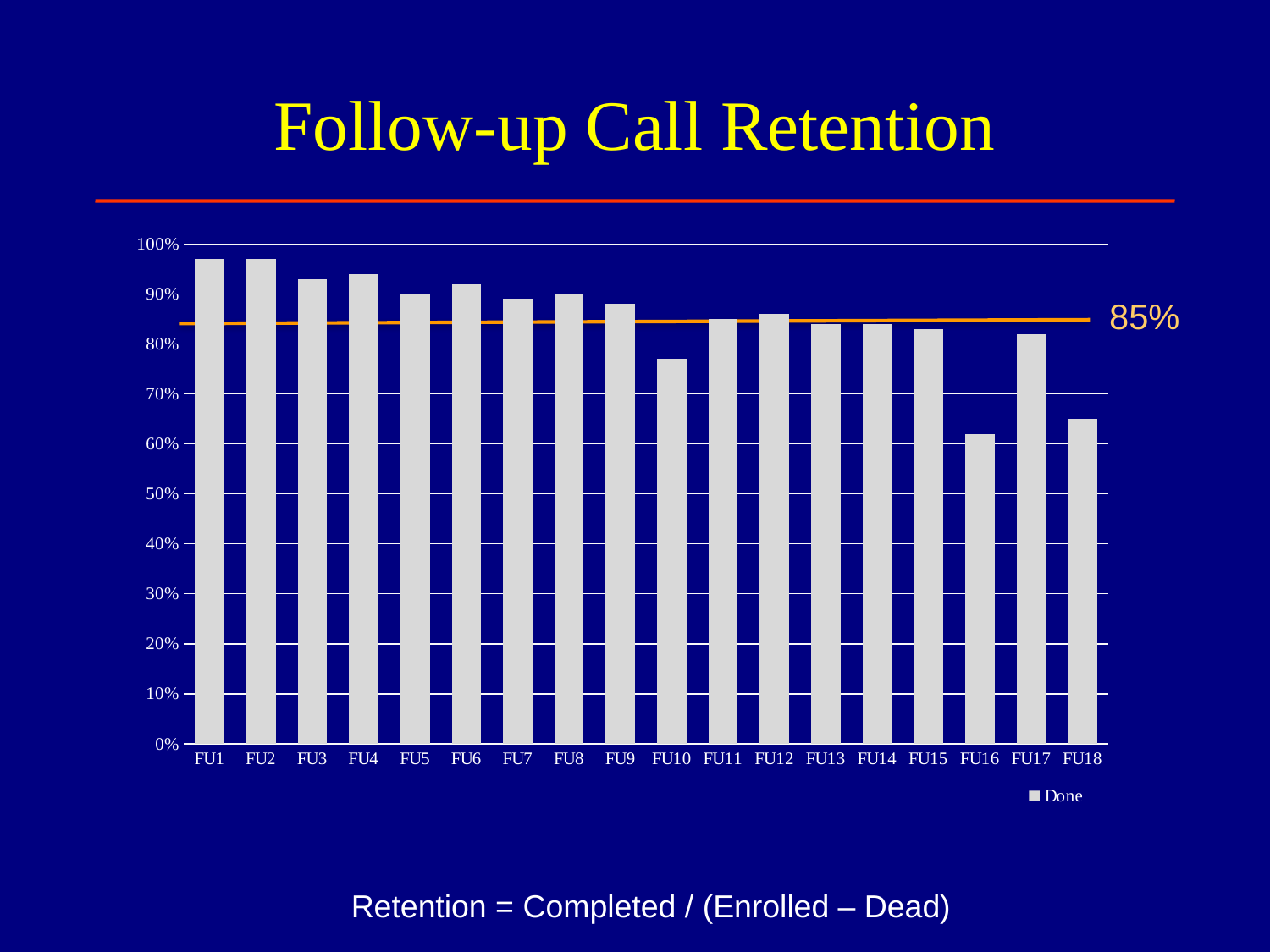
What type of chart is shown on the slide? bar chart Is the retention value for FU16 greater or less than 70%? less Is the retention value for FU18 greater or less than 70%? less Which follow-up call has the lowest retention? FU16 How many follow-up call categories are plotted along the x axis? 18 What value is labelled on the horizontal reference line drawn across the chart? 85% Is the retention value for FU1 greater or less than 90%? greater Do the retention values generally rise or fall from FU1 to FU18? fall Which has the higher retention, FU3 or FU10? FU3 What is the title of the chart on the slide? Follow-up Call Retention How many series does the legend list? 1